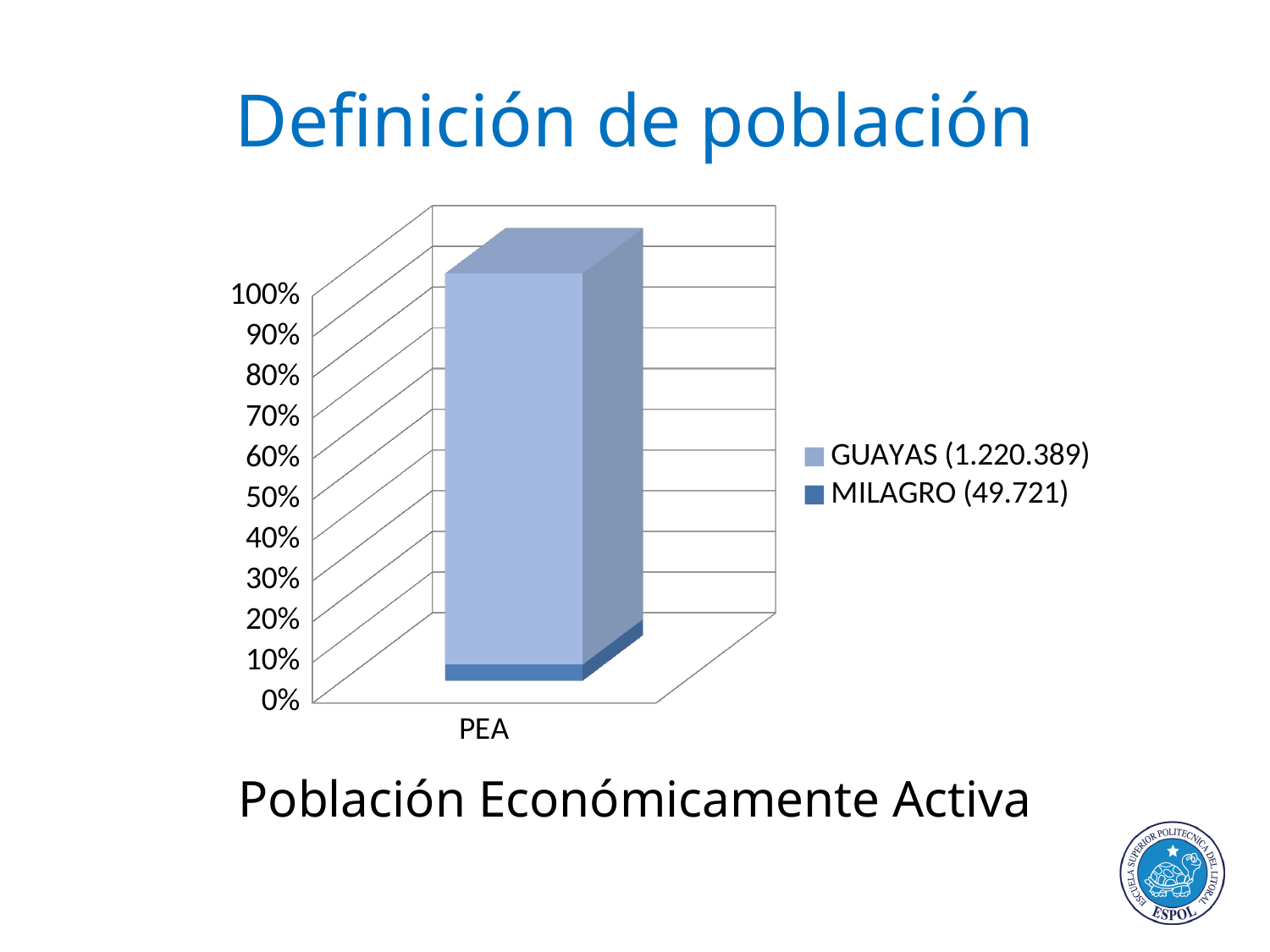
Which series has the smallest share of the PEA bar? MILAGRO How many series does the legend list? 2 What value is shown in the legend for GUAYAS? 1.220.389 What is the difference between the GUAYAS value and the MILAGRO value shown in the legend? 1.170.668 How many categories are shown on the x axis? 1 What value is shown in the legend for MILAGRO? 49.721 What is the highest value shown on the vertical axis? 100% Which series takes up the larger share of the PEA bar, GUAYAS or MILAGRO? GUAYAS Is the share of the PEA bar for MILAGRO greater or less than 20%? less What kind of chart is shown on the slide? Bar chart What is the label of the category on the x axis? PEA Is the share of the PEA bar for GUAYAS greater or less than 50%? greater